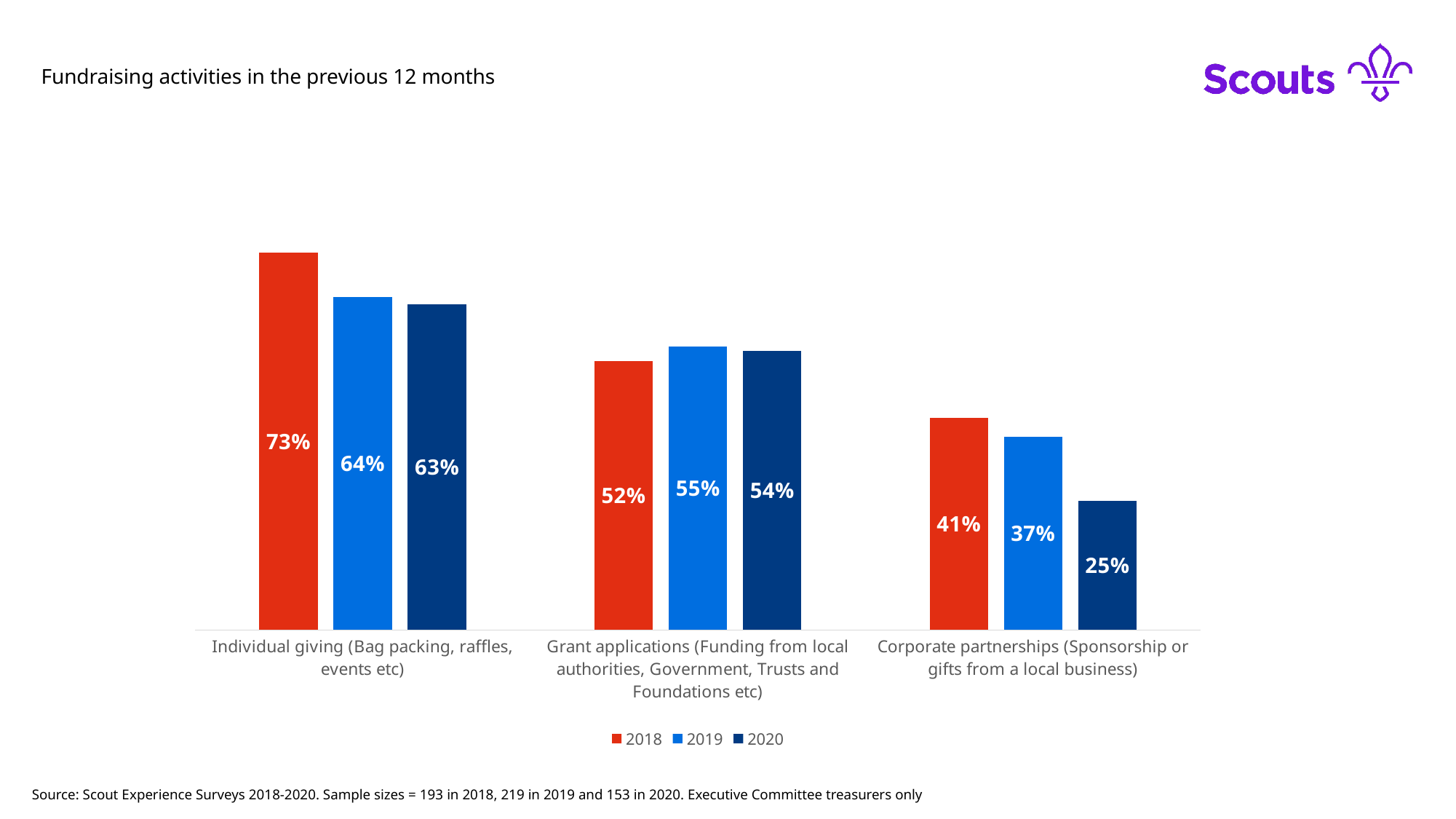
Which is larger for Grant applications: the 2018 value or the 2019 value? 2019 What percentage of respondents reported Individual giving in 2018? 73% How many fundraising activity categories are shown on the chart? 3 Which fundraising activity has the highest value in 2018? Individual giving (Bag packing, raffles, events etc) What kind of chart is shown on the slide? Bar chart Do the values for Corporate partnerships rise or fall from 2018 to 2020? Fall What is the value for Grant applications in 2019? 55% What is the difference between the 2018 and 2020 values for Corporate partnerships? 16% Which fundraising activity has the lowest value in 2020? Corporate partnerships (Sponsorship or gifts from a local business) What is the difference between the 2018 and 2019 values for Individual giving? 9% What is the value for Corporate partnerships in 2020? 25% How many series does the legend list? 3